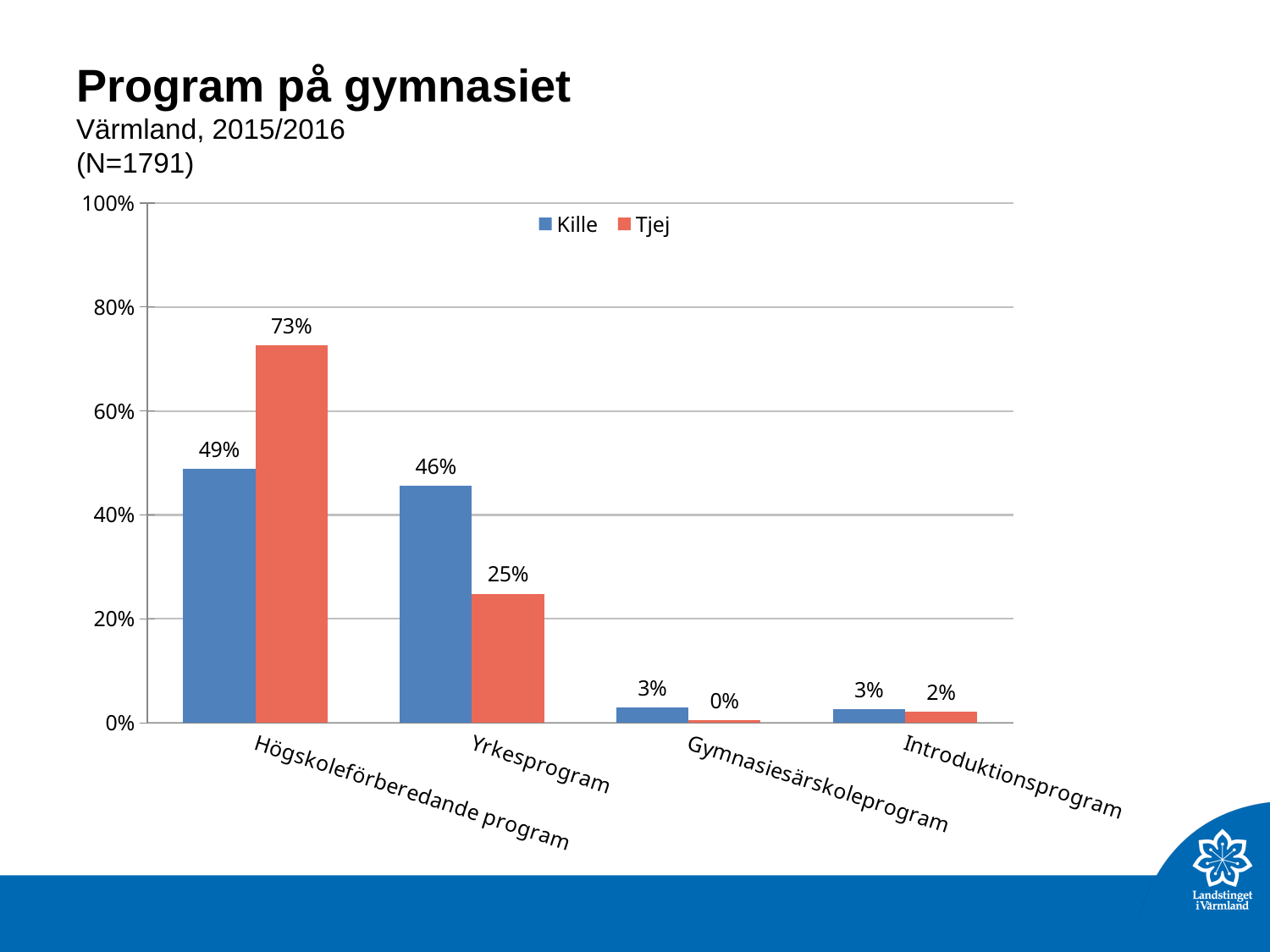
What is the difference between the Kille and Tjej values in the Yrkesprogram category? 21% How many series does the legend list? 2 How many categories are shown on the x axis? 4 Which category has the highest value for Tjej? Högskoleförberedande program What is the value for Tjej in the Gymnasiesärskoleprogram category? 0% Which category has the lowest value for Tjej? Gymnasiesärskoleprogram What is the value for Kille in the Yrkesprogram category? 46% What kind of chart is shown on the slide? Bar chart What is the value for Kille in the Introduktionsprogram category? 3% What is the difference between the Tjej and Kille values in the Högskoleförberedande program category? 24% What is the value for Tjej in the Högskoleförberedande program category? 73% In the Yrkesprogram category, which series has the larger value, Kille or Tjej? Kille